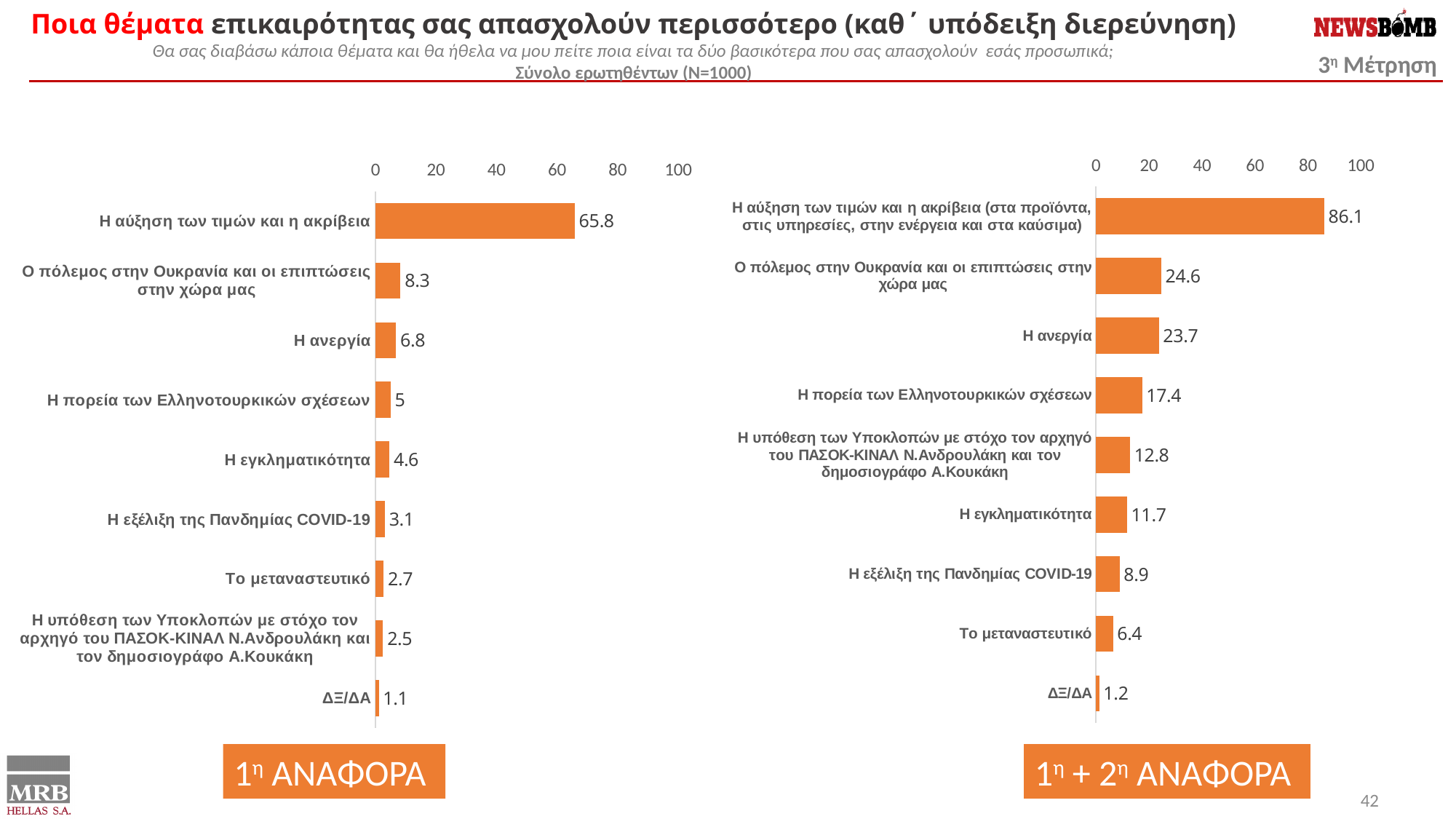
In the right chart (1η + 2η ΑΝΑΦΟΡΑ), what is the difference between the values for 'Ο πόλεμος στην Ουκρανία και οι επιπτώσεις στην χώρα μας' and 'Η πορεία των Ελληνοτουρκικών σχέσεων'? 7.2 What is the label shown in the orange box below the left chart? 1η ΑΝΑΦΟΡΑ In the left chart (1η ΑΝΑΦΟΡΑ), what is the value for 'Η αύξηση των τιμών και η ακρίβεια'? 65.8 In the left chart (1η ΑΝΑΦΟΡΑ), which category has the lowest value? ΔΞ/ΔΑ In the right chart (1η + 2η ΑΝΑΦΟΡΑ), what is the value for 'Η εξέλιξη της Πανδημίας COVID-19'? 8.9 In the left chart (1η ΑΝΑΦΟΡΑ), which is larger: the value for 'Η ανεργία' or the value for 'Η εγκληματικότητα'? Η ανεργία In the right chart (1η + 2η ΑΝΑΦΟΡΑ), which category has the highest value? Η αύξηση των τιμών και η ακρίβεια (στα προϊόντα, στις υπηρεσίες, στην ενέργεια και στα καύσιμα) In the left chart (1η ΑΝΑΦΟΡΑ), what is the value for 'Το μεταναστευτικό'? 2.7 In the right chart (1η + 2η ΑΝΑΦΟΡΑ), what is the value for 'Η ανεργία'? 23.7 In the right chart (1η + 2η ΑΝΑΦΟΡΑ), is the value for 'Η υπόθεση των Υποκλοπών...' greater or less than 20? less How many categories are shown in the left chart (1η ΑΝΑΦΟΡΑ)? 9 What kind of chart is the right chart (1η + 2η ΑΝΑΦΟΡΑ)? bar chart